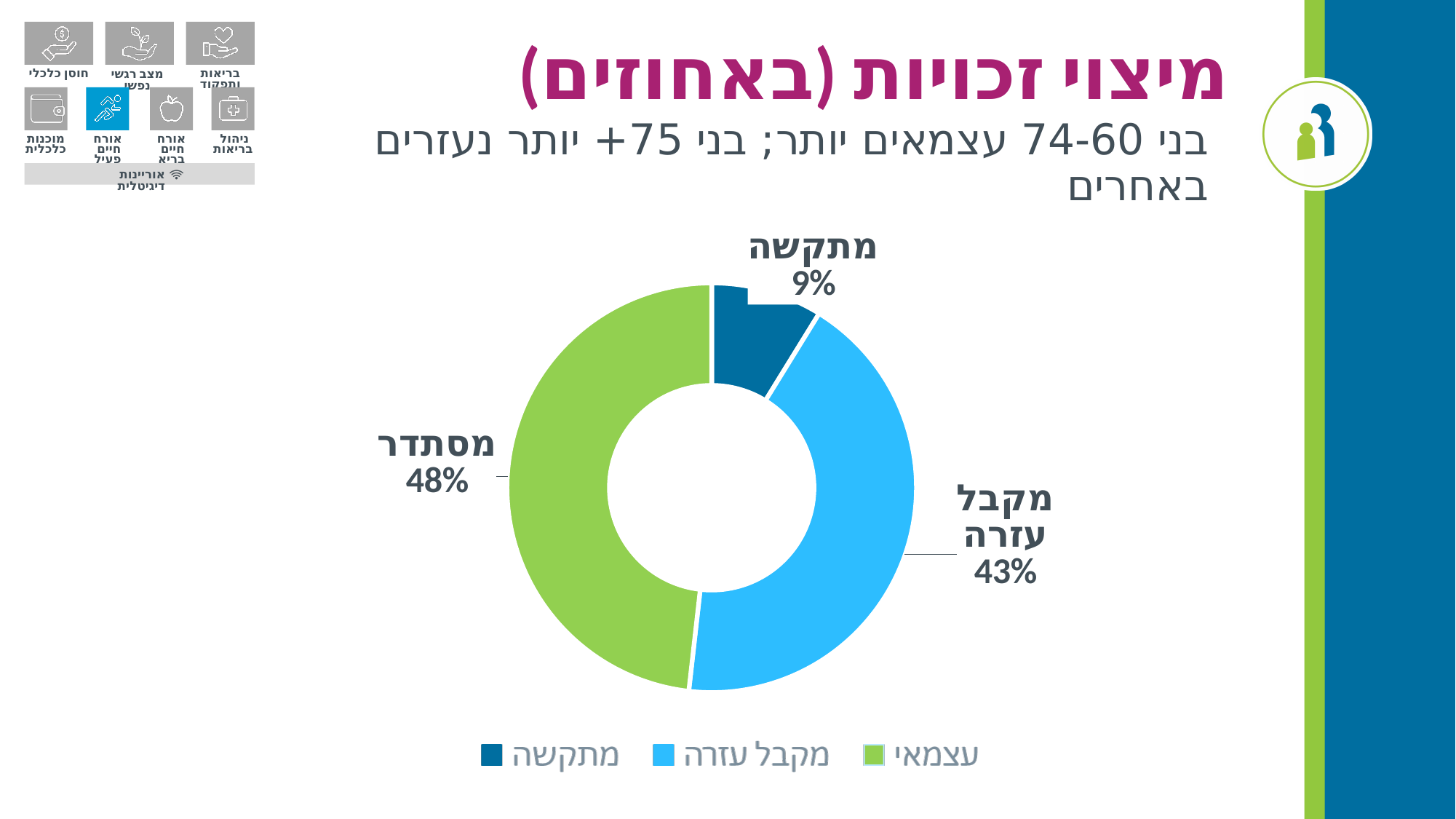
What kind of chart is shown on the slide? Pie (donut) chart How many entries does the chart legend list? 3 Which is larger, the מקבל עזרה slice or the מתקשה slice? מקבל עזרה Which slice of the pie chart is the largest? מסתדר What is the difference in percentage points between the מקבל עזרה slice and the מתקשה slice? 34 What percentage of the pie chart is labelled מקבל עזרה? 43% What percentage of the pie chart is labelled מסתדר? 48% What is the difference in percentage points between the מסתדר slice and the מקבל עזרה slice? 5 What percentage of the pie chart is labelled מתקשה? 9% Which slice of the pie chart is the smallest? מתקשה How many slices does the pie chart have? 3 What is the title of the slide containing the chart? מיצוי זכויות (באחוזים)